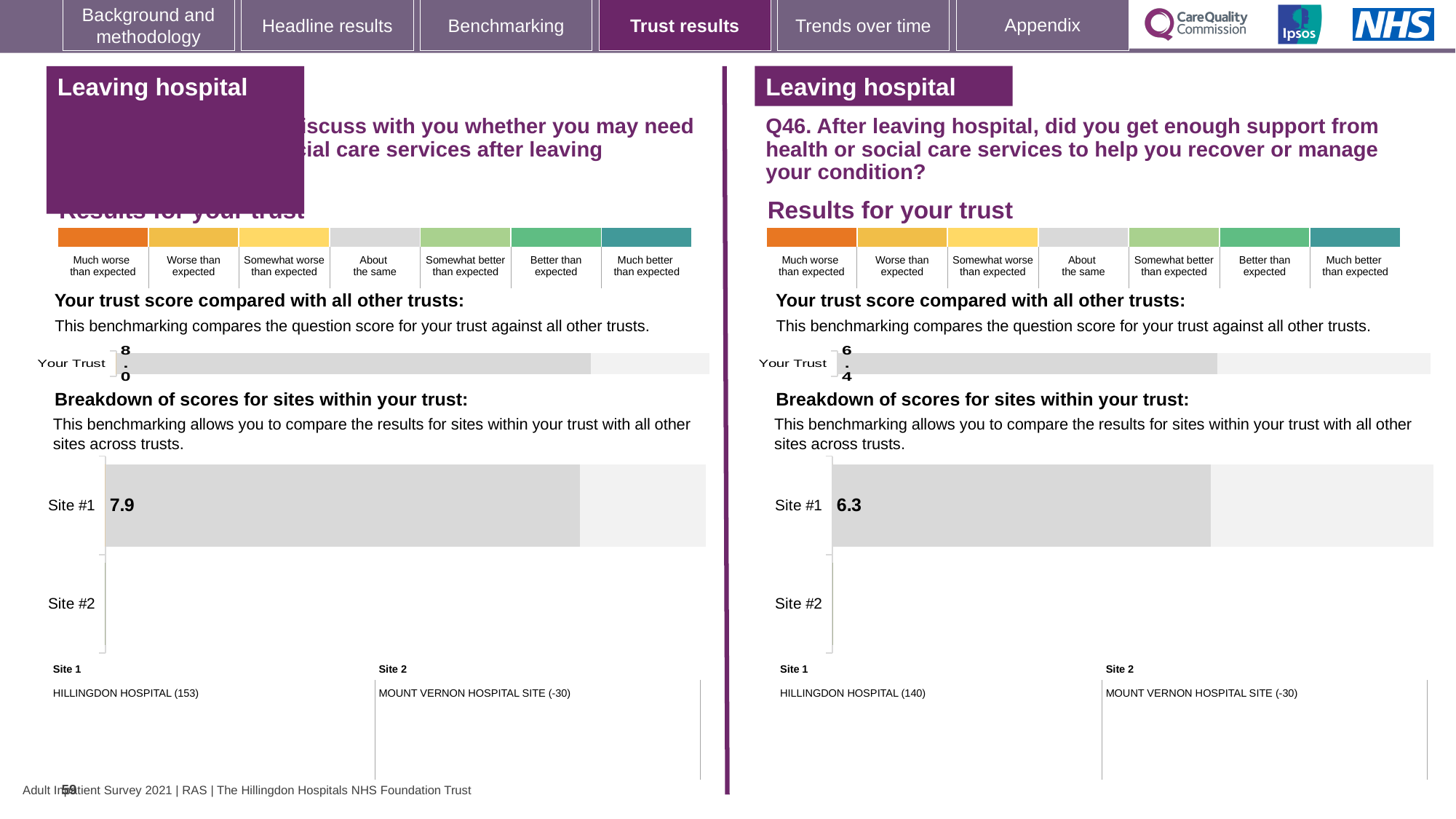
On the left-hand chart, what is the difference between the Your Trust score and the Site #1 score? 0.1 Which hospital is listed as Site 1 under the right-hand chart (Q46)? HILLINGDON HOSPITAL (140) On the left-hand chart, what is the score shown for Site #1? 7.9 On the right-hand chart (Q46), what is the difference between the Your Trust score and the Site #1 score? 0.1 On the right-hand chart (Q46), which is larger: the Your Trust score or the Site #1 score? Your Trust On the right-hand chart (Q46), what is the score shown for Your Trust? 6.4 Which Site #1 score is higher: the one on the left-hand chart or the one on the right-hand chart (Q46)? Left-hand chart (7.9) What type of chart is used to show the breakdown of scores for sites within the trust? Bar chart On the left-hand chart, what is the score shown for Your Trust? 8.0 How many sites are listed in the site breakdown chart on the right-hand side (Q46)? 2 On the right-hand chart (Q46), which site has no bar plotted? Site #2 On the right-hand chart (Q46), what is the score shown for Site #1? 6.3